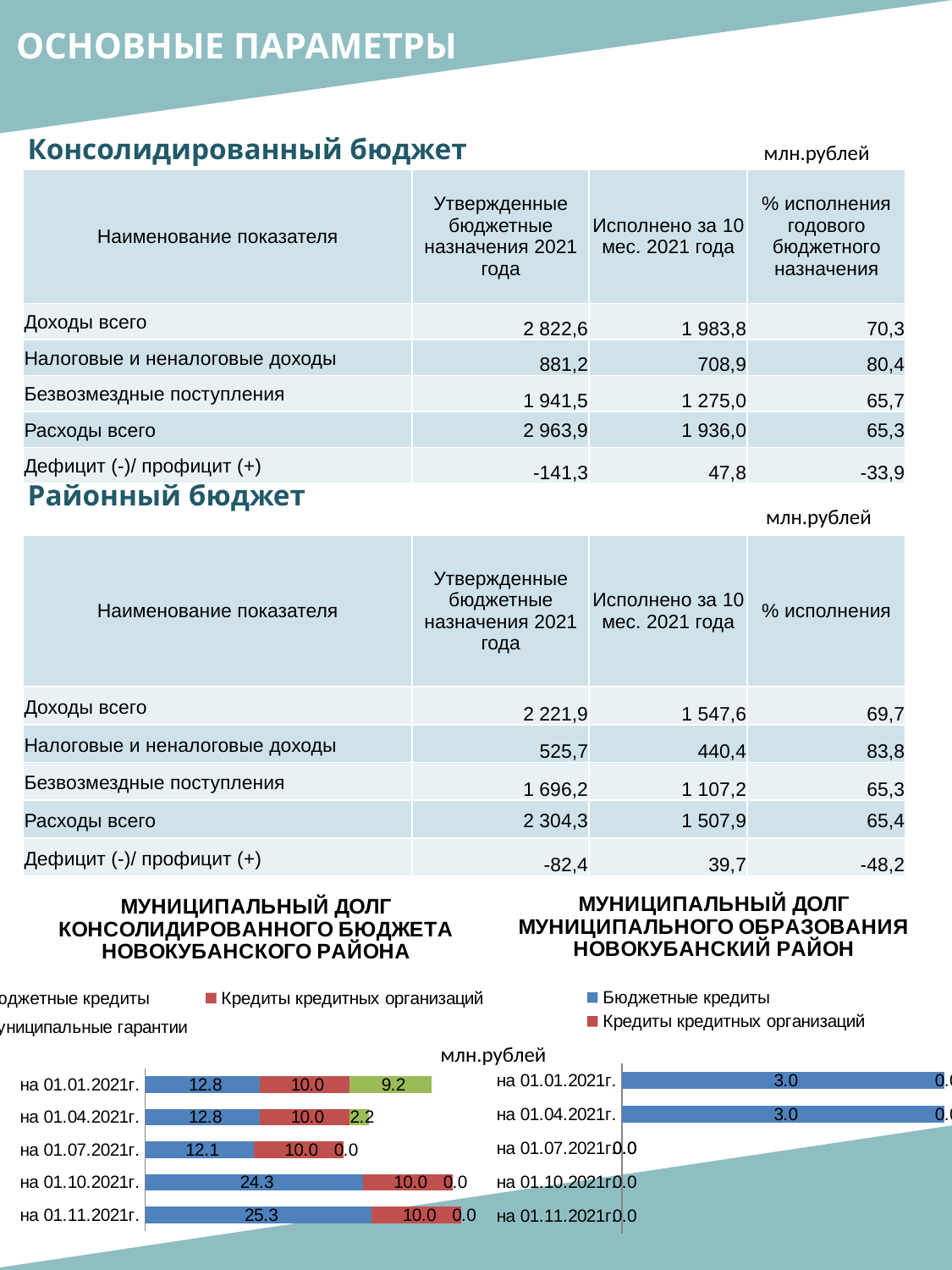
On the left chart (Муниципальный долг консолидированного бюджета Новокубанского района), on which date is Бюджетные кредиты highest? на 01.11.2021г. On the left chart (Муниципальный долг консолидированного бюджета Новокубанского района), which is larger: Муниципальные гарантии on 01.01.2021 or on 01.04.2021? на 01.01.2021г. What type of chart is the left chart (Муниципальный долг консолидированного бюджета Новокубанского района)? Stacked bar chart On the left chart (Муниципальный долг консолидированного бюджета Новокубанского района), how many series does the legend list? 3 On the left chart (Муниципальный долг консолидированного бюджета Новокубанского района), what is the value of Бюджетные кредиты on 01.11.2021? 25.3 On the left chart (Муниципальный долг консолидированного бюджета Новокубанского района), what is the total of the stacked bar for 01.01.2021? 32.0 On the right chart (Муниципальный долг муниципального образования Новокубанский район), what is the value of Бюджетные кредиты on 01.04.2021? 3.0 On the left chart (Муниципальный долг консолидированного бюджета Новокубанского района), on which date is Бюджетные кредиты lowest? на 01.07.2021г. On the left chart (Муниципальный долг консолидированного бюджета Новокубанского района), what is the difference between Бюджетные кредиты on 01.11.2021 and on 01.10.2021? 1.0 On the left chart (Муниципальный долг консолидированного бюджета Новокубанского района), what is the value of Кредиты кредитных организаций on 01.10.2021? 10.0 On the right chart (Муниципальный долг муниципального образования Новокубанский район), how many dates are shown on the axis? 5 On the left chart (Муниципальный долг консолидированного бюджета Новокубанского района), what is the value of Муниципальные гарантии on 01.01.2021? 9.2